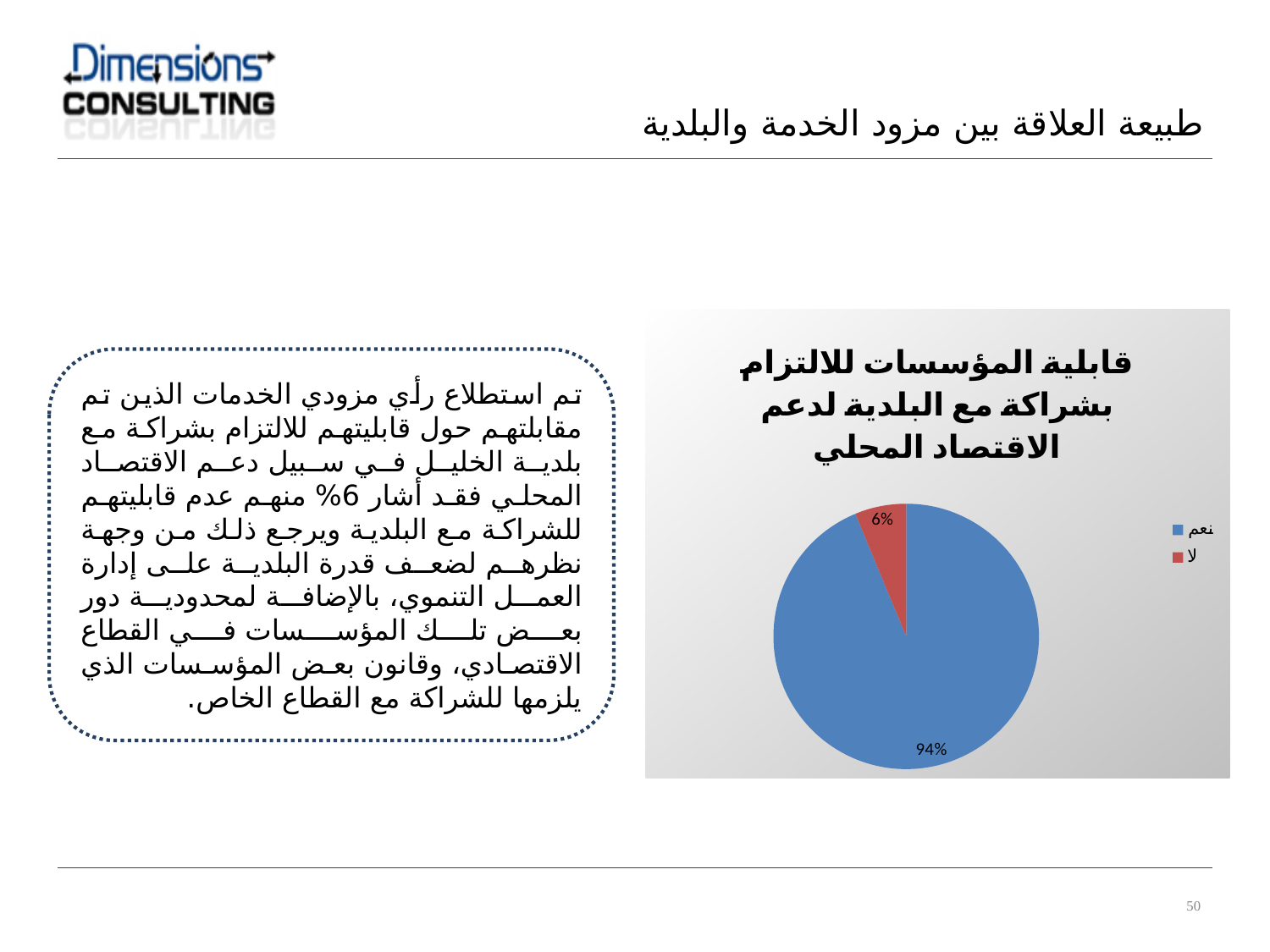
What colour is the "لا" slice in the pie chart? red What is the title of the pie chart? قابلية المؤسسات للالتزام بشراكة مع البلدية لدعم الاقتصاد المحلي What share of the pie does the "لا" slice represent? 6% How many slices does the pie chart have? 2 How many entries does the legend list? 2 What is the difference in percentage points between the "نعم" and "لا" slices? 88 Which is larger, the "نعم" slice or the "لا" slice? نعم Which category has the smallest slice in the pie chart? لا Which category has the largest slice in the pie chart? نعم What type of chart is shown on the slide? pie chart What share of the pie does the "نعم" slice represent? 94%